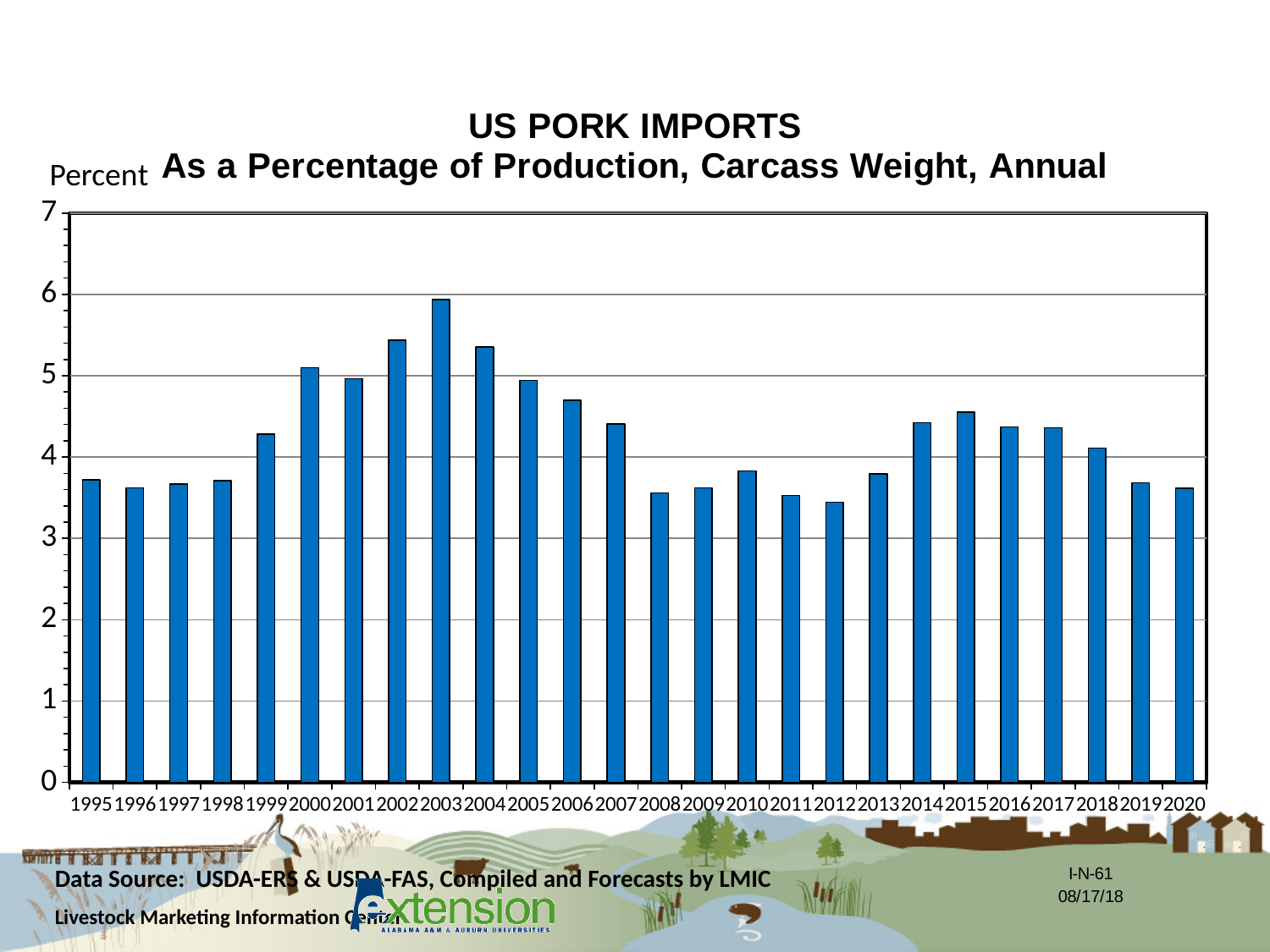
How many years (bars) are plotted on the chart? 26 Is the value for 2000 greater or less than 5? greater What label is shown on the vertical axis of the chart? Percent Do the values rise or fall from 2003 to 2008? fall What kind of chart is shown on the slide? bar chart Is the value for 2015 greater or less than 4? greater Which is larger, the value for 2003 or the value for 2012? 2003 Is the value for 2012 greater or less than 4? less Which is larger, the value for 2015 or the value for 2019? 2015 Which year has the highest value for US pork imports as a percentage of production? 2003